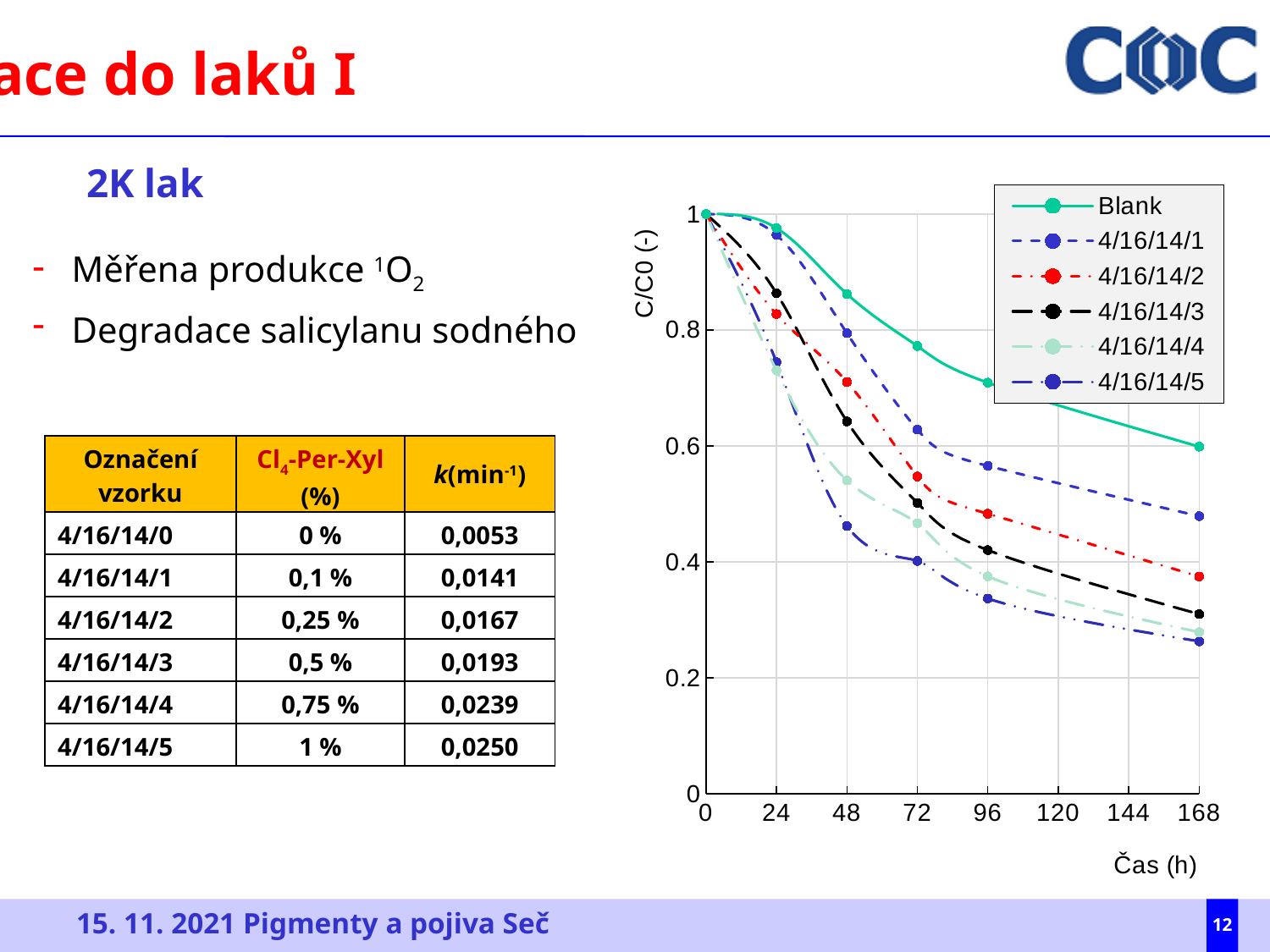
What kind of chart is shown on the slide? line chart What is the C/C0 value of the Blank series at time 0 h? 1 Is the C/C0 value for 4/16/14/5 at 168 h greater or less than 0.2? greater Is the C/C0 value for 4/16/14/1 at 168 h greater or less than 0.6? less Is the C/C0 value for Blank at 96 h greater or less than 0.6? greater Do the C/C0 values of the series rise or fall as time increases along the x axis? fall At 96 h, which series has the larger C/C0 value, Blank or 4/16/14/1? Blank How many series does the chart legend list? 6 At 72 h, which series has the larger C/C0 value, 4/16/14/2 or 4/16/14/3? 4/16/14/2 What is the label of the x axis of the chart? Čas (h) Which series has the lowest C/C0 value at 48 h? 4/16/14/5 Which series has the highest C/C0 value at 48 h? Blank